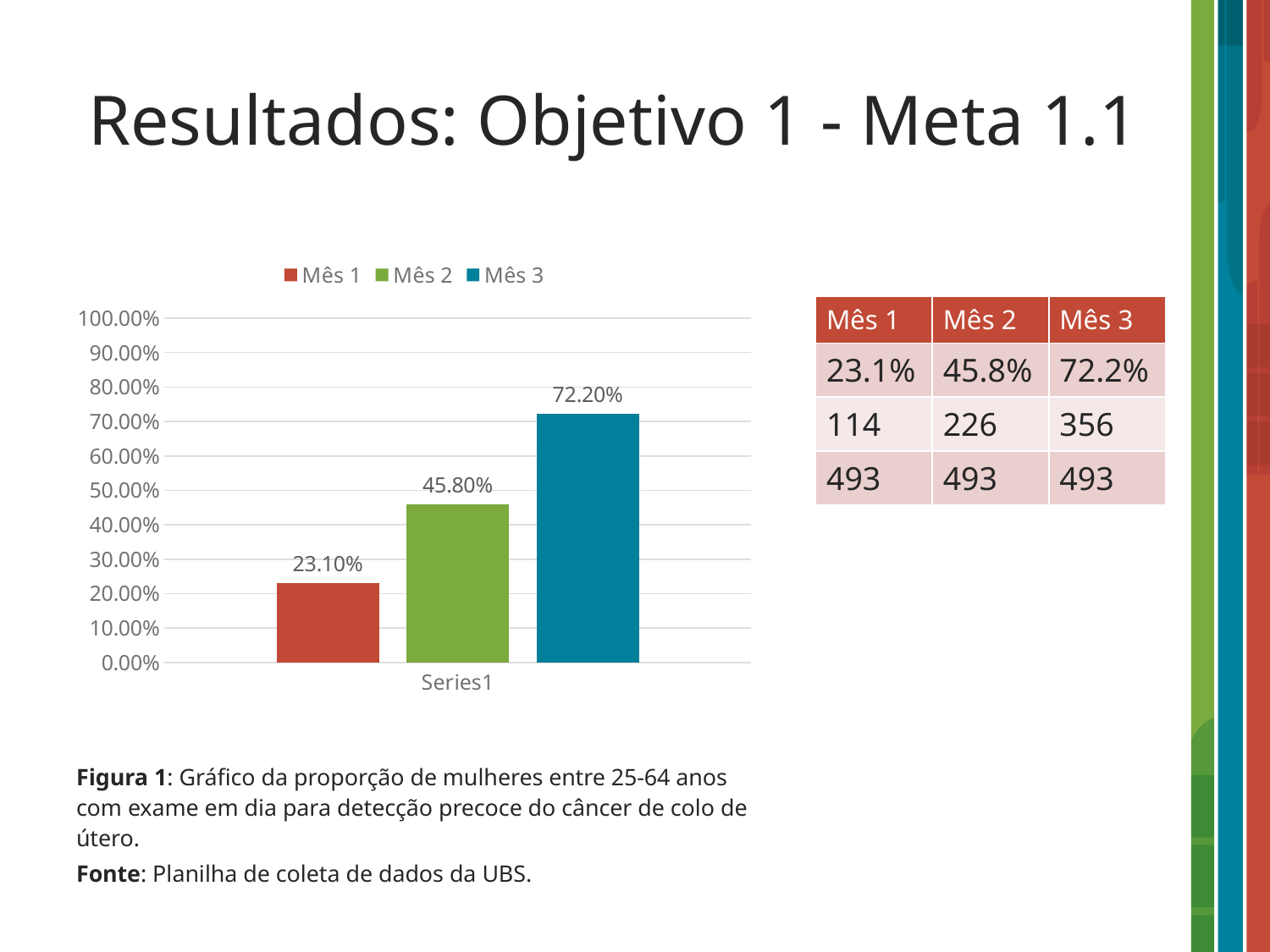
Which series has the lowest value in the chart? Mês 1 Which series has the highest value in the chart? Mês 3 What is the difference between the values for Mês 2 and Mês 1? 22.70% What kind of chart is shown on the slide? bar chart What is the difference between the values for Mês 3 and Mês 1? 49.10% What is the value for Mês 1 in the chart? 23.10% Is the value for Mês 2 greater or less than 50.00%? less How many series does the legend list? 3 Which is larger, the value for Mês 2 or the value for Mês 3? Mês 3 Do the values rise or fall from Mês 1 to Mês 3? rise What is the value for Mês 3 in the chart? 72.20% What is the value for Mês 2 in the chart? 45.80%